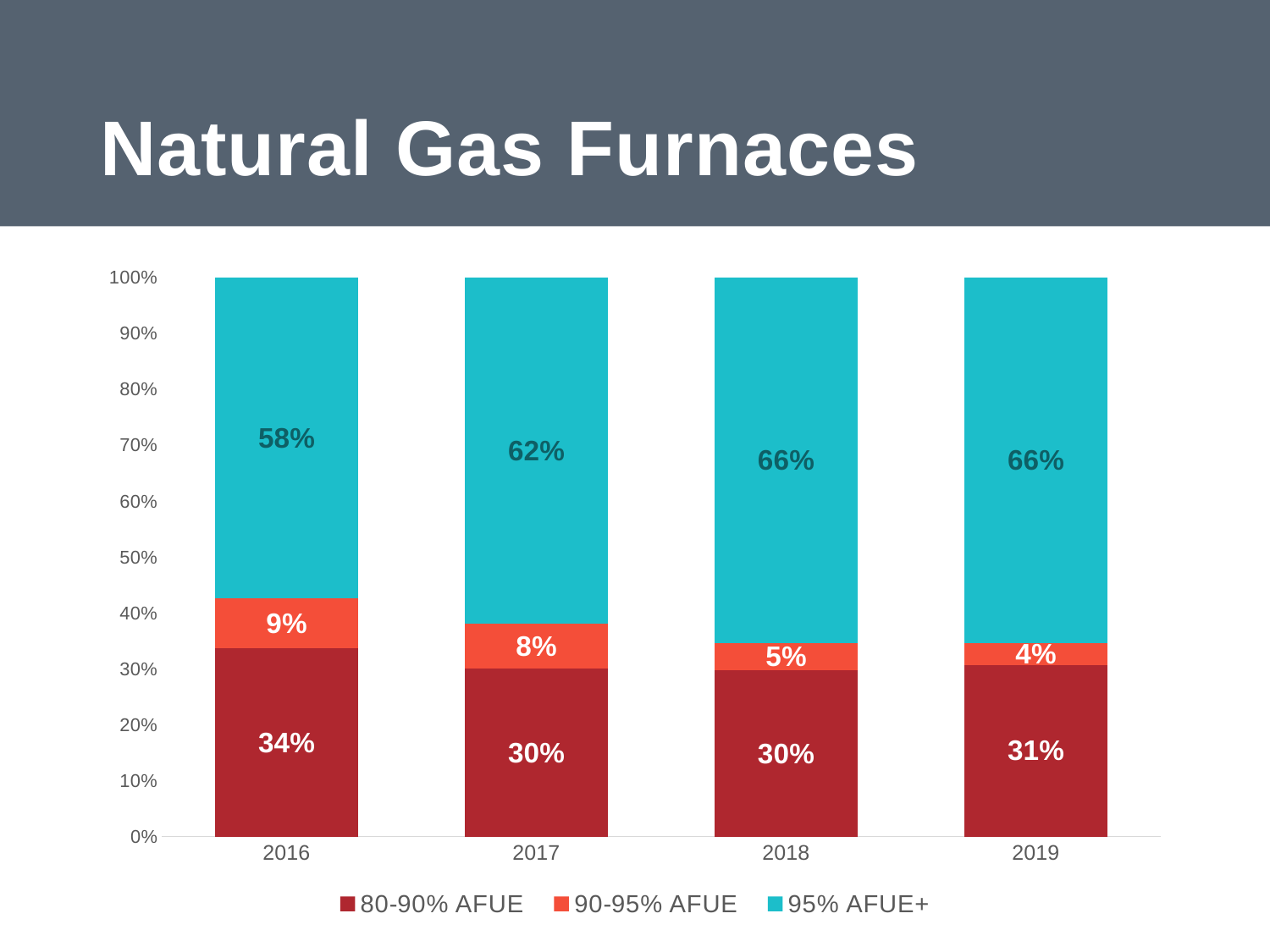
What is the title of the slide? Natural Gas Furnaces In which year is the 95% AFUE+ share lowest? 2016 How many series does the legend list? 3 What kind of chart is shown on the slide? Stacked bar chart Does the 90-95% AFUE share rise or fall from 2016 to 2019? Fall How many years are shown on the x axis? 4 What is the difference between the 95% AFUE+ values for 2018 and 2016? 8% What is the value for 95% AFUE+ in 2016? 58% Which is larger, the 80-90% AFUE value in 2016 or in 2017? 2016 What is the value for 90-95% AFUE in 2018? 5% What is the value for 80-90% AFUE in 2019? 31% In which year is the 90-95% AFUE share highest? 2016